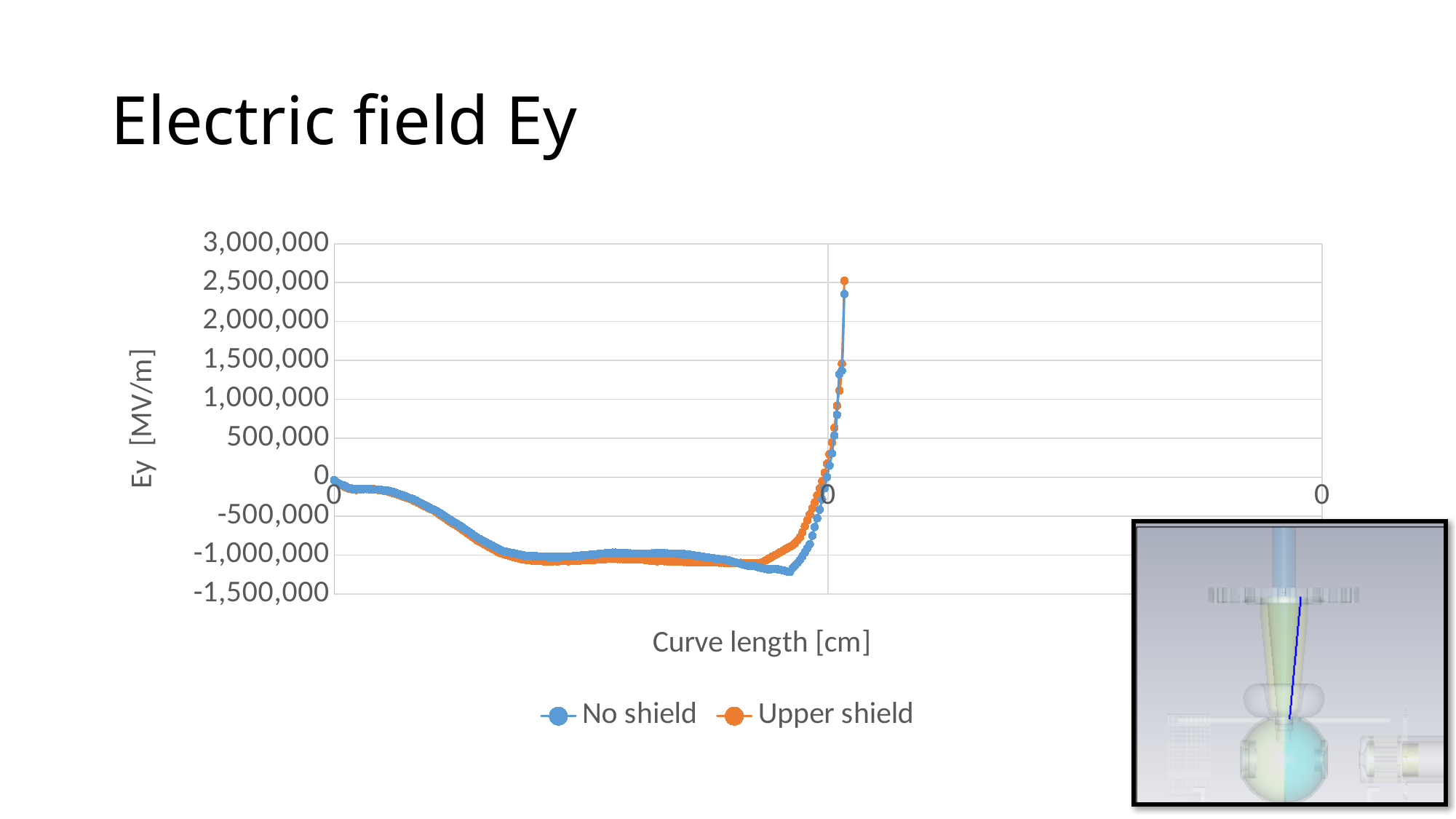
What are the names of the two series in the legend? No shield and Upper shield What is the highest tick value shown on the vertical axis? 3,000,000 Is the peak value of the Upper shield series greater or less than 2,000,000? greater Which series reaches the lower minimum value, No shield or Upper shield? No shield What kind of chart is shown on the slide? Line chart What is the label of the vertical axis? Ey [MV/m] Is the value of the Upper shield series at the start of the curve (left end) greater or less than 500,000? less How many series does the legend list? 2 Is the lowest value of the No shield series greater or less than -1,000,000? less What is the lowest tick value shown on the vertical axis? -1,500,000 Which series reaches the higher peak value, No shield or Upper shield? Upper shield